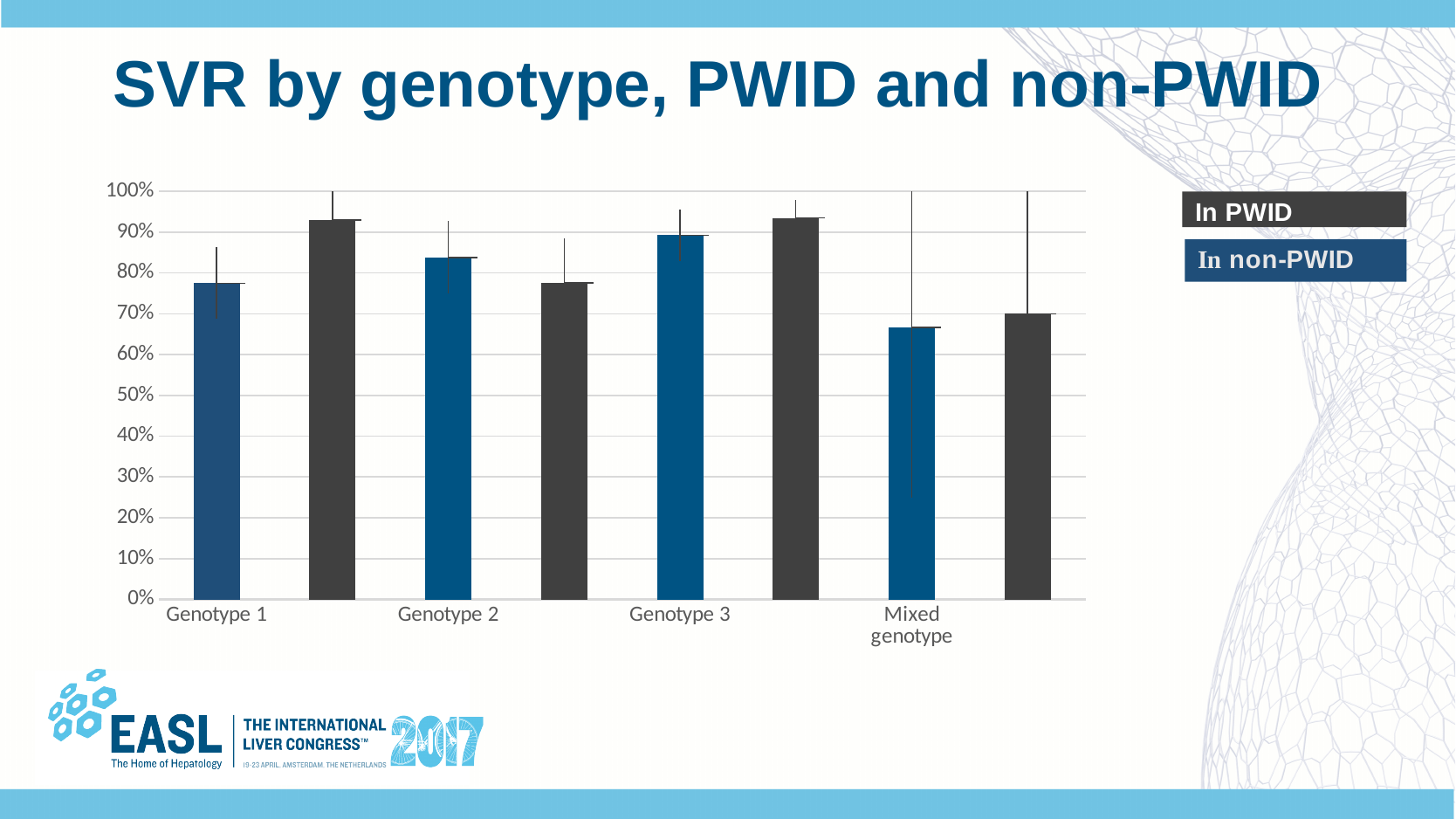
Is the value of the dark (PWID) bar for Genotype 2 greater or less than 80%? less Which series is shown in blue according to the legend? In non-PWID What kind of chart is shown on the slide? bar chart Is the value of the dark (PWID) bar for Genotype 1 greater or less than 90%? greater Is the value of the blue (non-PWID) bar for Mixed genotype greater or less than 70%? less What is the title of the chart? SVR by genotype, PWID and non-PWID How many series does the legend list? 2 For Genotype 2, which bar is taller, the blue (non-PWID) bar or the dark (PWID) bar? the blue (non-PWID) bar Which genotype category has the lowest blue (non-PWID) bar? Mixed genotype How many genotype categories are shown on the x axis? 4 For Genotype 1, which bar is taller, the blue (non-PWID) bar or the dark (PWID) bar? the dark (PWID) bar